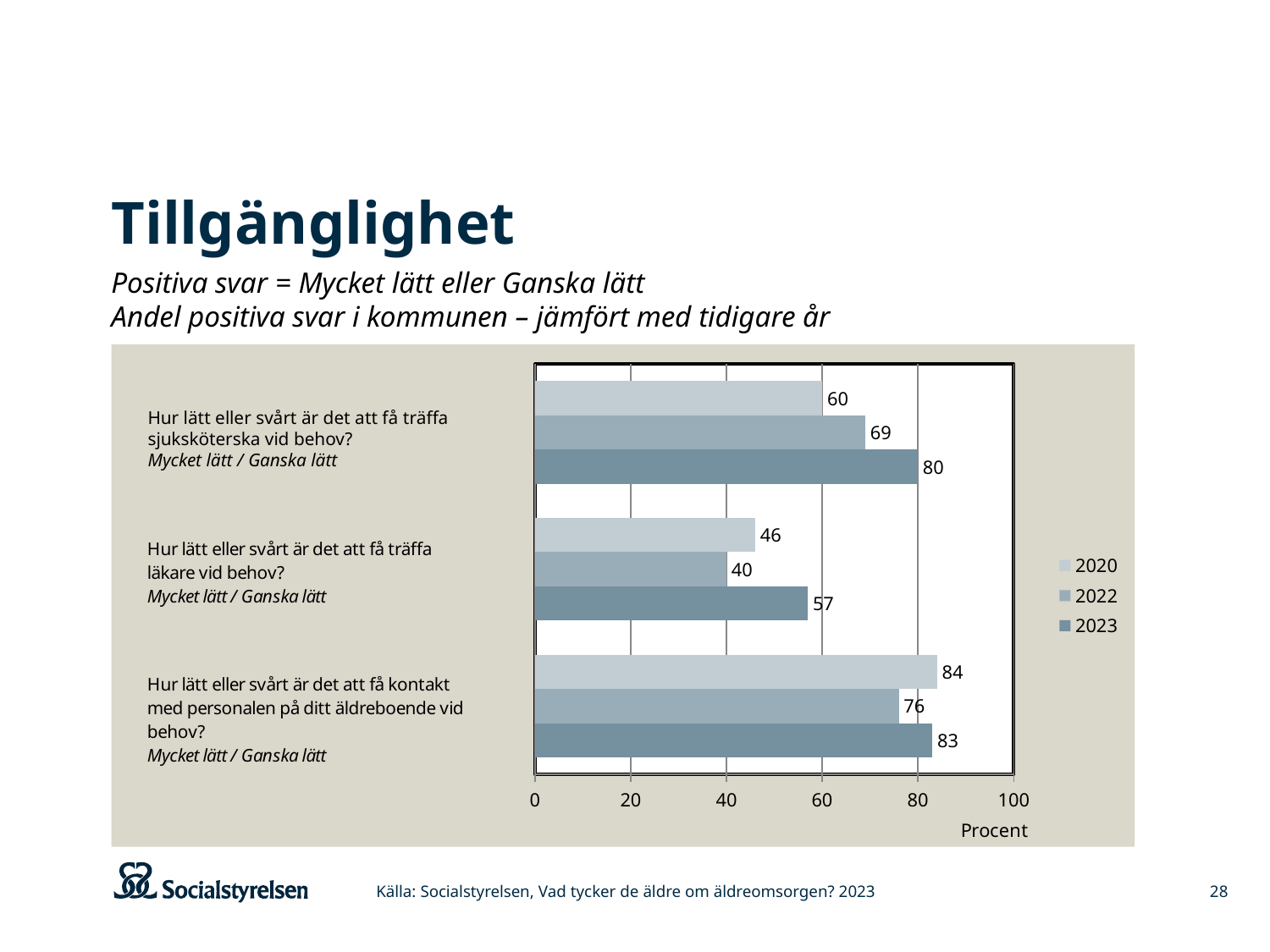
What kind of chart is shown on the slide? Bar chart What is the 2020 value for "Hur lätt eller svårt är det att få kontakt med personalen på ditt äldreboende vid behov?"? 84 What is the label on the horizontal axis of the chart? Procent What is the 2022 value for "Hur lätt eller svårt är det att få träffa läkare vid behov?"? 40 Which year has the highest value for "Hur lätt eller svårt är det att få träffa läkare vid behov?"? 2023 Which year has the lowest value for "Hur lätt eller svårt är det att få träffa sjuksköterska vid behov?"? 2020 Which is larger for "Hur lätt eller svårt är det att få kontakt med personalen på ditt äldreboende vid behov?": the 2020 value or the 2022 value? 2020 What is the difference between the 2023 and 2020 values for "Hur lätt eller svårt är det att få träffa sjuksköterska vid behov?"? 20 How many question categories are shown in the chart? 3 How many series does the legend list? 3 Which years are listed in the chart legend? 2020, 2022, 2023 What is the 2023 value for "Hur lätt eller svårt är det att få träffa sjuksköterska vid behov?"? 80